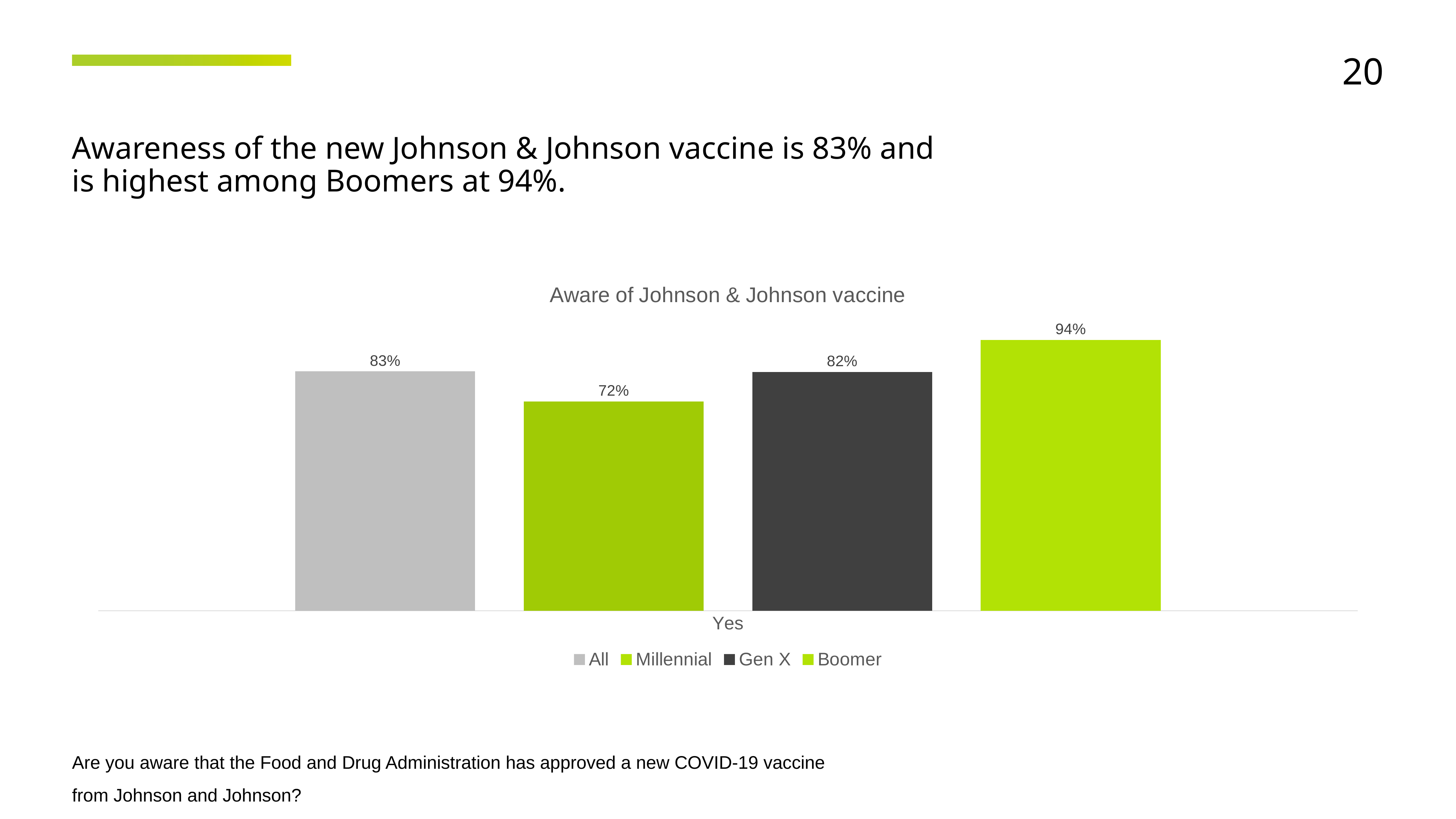
Which series has the lowest value in the chart? Millennial What kind of chart is shown on the slide? Bar chart What is the value for All in the chart? 83% What is the difference between the All value and the Gen X value? 1% What is the value for Boomer in the chart? 94% Which is larger, the value for Gen X or the value for Millennial? Gen X What is the value for Millennial in the chart? 72% What is the value for Gen X in the chart? 82% How many series does the legend list? 4 Which series has the highest value in the chart? Boomer What is the title of the chart? Aware of Johnson & Johnson vaccine What is the difference between the Boomer value and the Millennial value? 22%